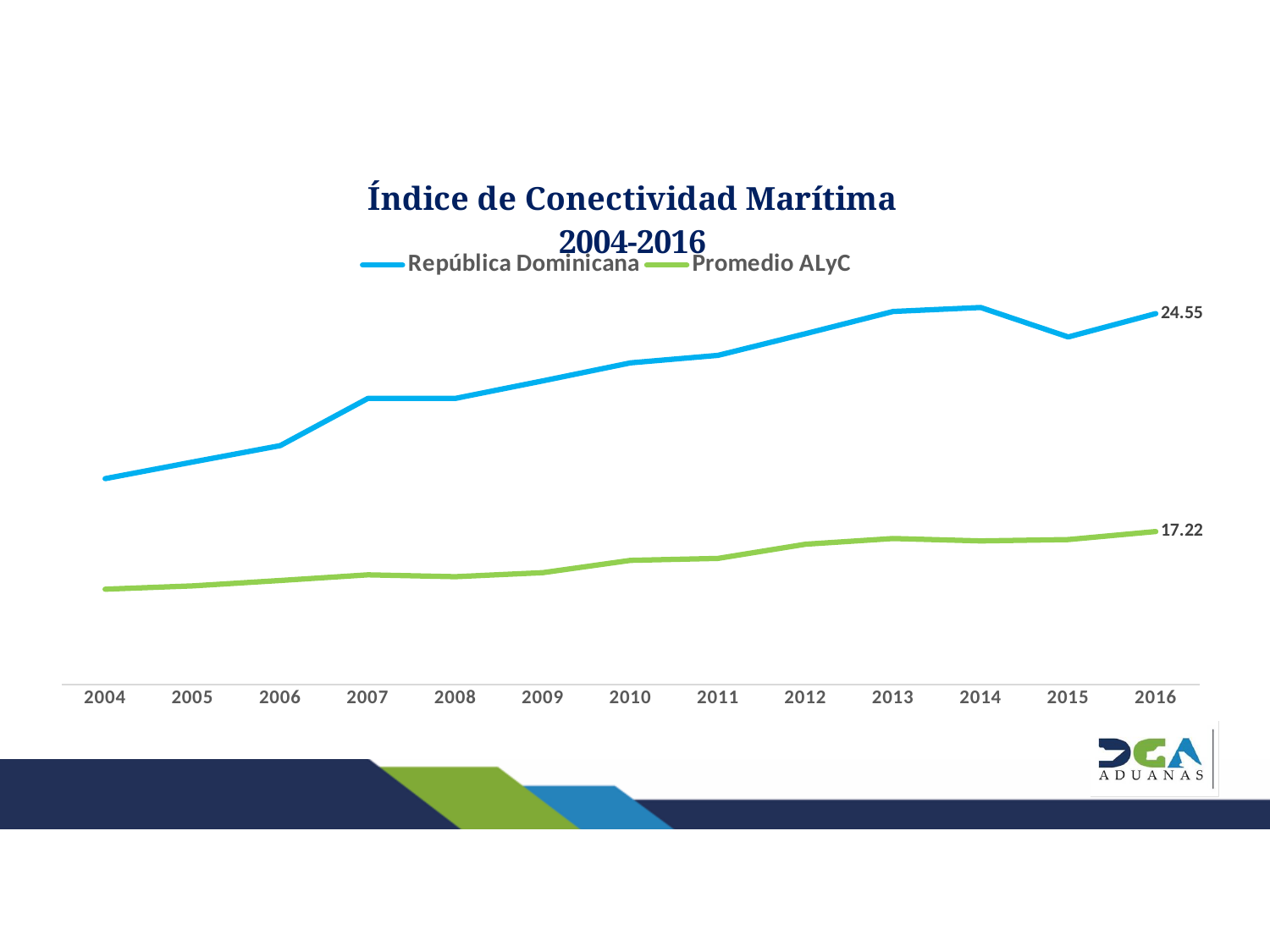
Does the República Dominicana line generally rise or fall from 2004 to 2016? Rise How many series does the legend list? 2 In which year is the República Dominicana value lowest? 2004 What is the value for Promedio ALyC in 2016? 17.22 What kind of chart is shown on the slide? Line chart In 2016, which series has the higher value, República Dominicana or Promedio ALyC? República Dominicana How many years are shown on the x axis? 13 What is the value for República Dominicana in 2016? 24.55 Which colour is used for the Promedio ALyC line? Green What is the difference between the República Dominicana and Promedio ALyC values in 2016? 7.33 What is the title of the chart? Índice de Conectividad Marítima 2004-2016 In which year is the Promedio ALyC value lowest? 2004